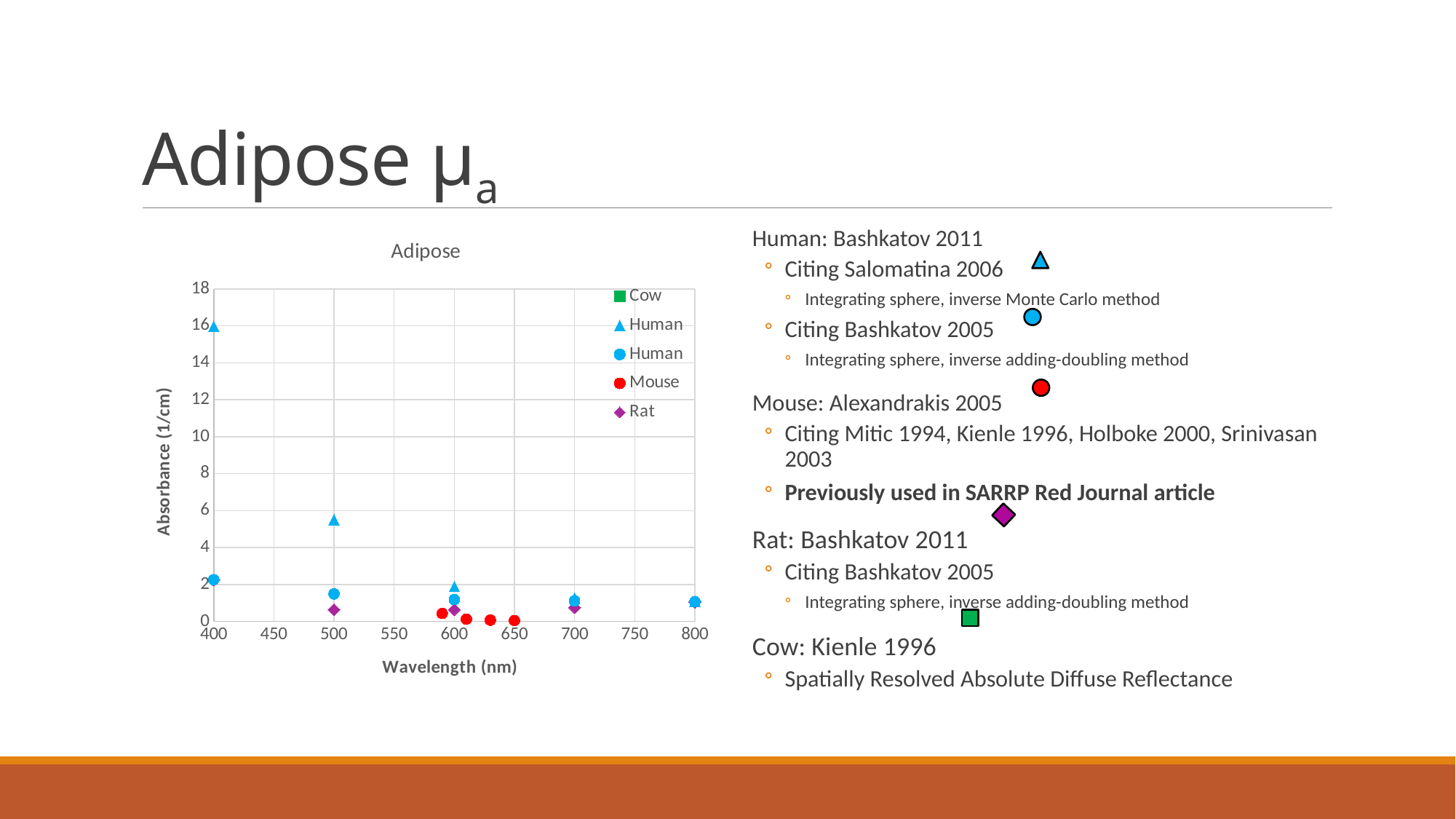
Is the absorbance value for the Mouse series at 650 nm greater or less than 2? less Do the Human (triangle) series values rise or fall as wavelength increases from 400 nm to 800 nm? fall What is the label of the y axis of the chart? Absorbance (1/cm) Is the absorbance value for the Human (triangle) series at 400 nm greater or less than 14? greater At 500 nm, which is larger: the Human (triangle) value or the Human (circle) value? Human (triangle) At 400 nm, which is larger: the Human (triangle) value or the Human (circle) value? Human (triangle) Which series has the highest plotted absorbance value on the chart? Human (triangle) What kind of chart is shown on the slide? scatter chart What is the title of the chart? Adipose Is the absorbance value for the Human (triangle) series at 500 nm greater or less than 4? greater How many series does the legend of the Adipose chart list? 5